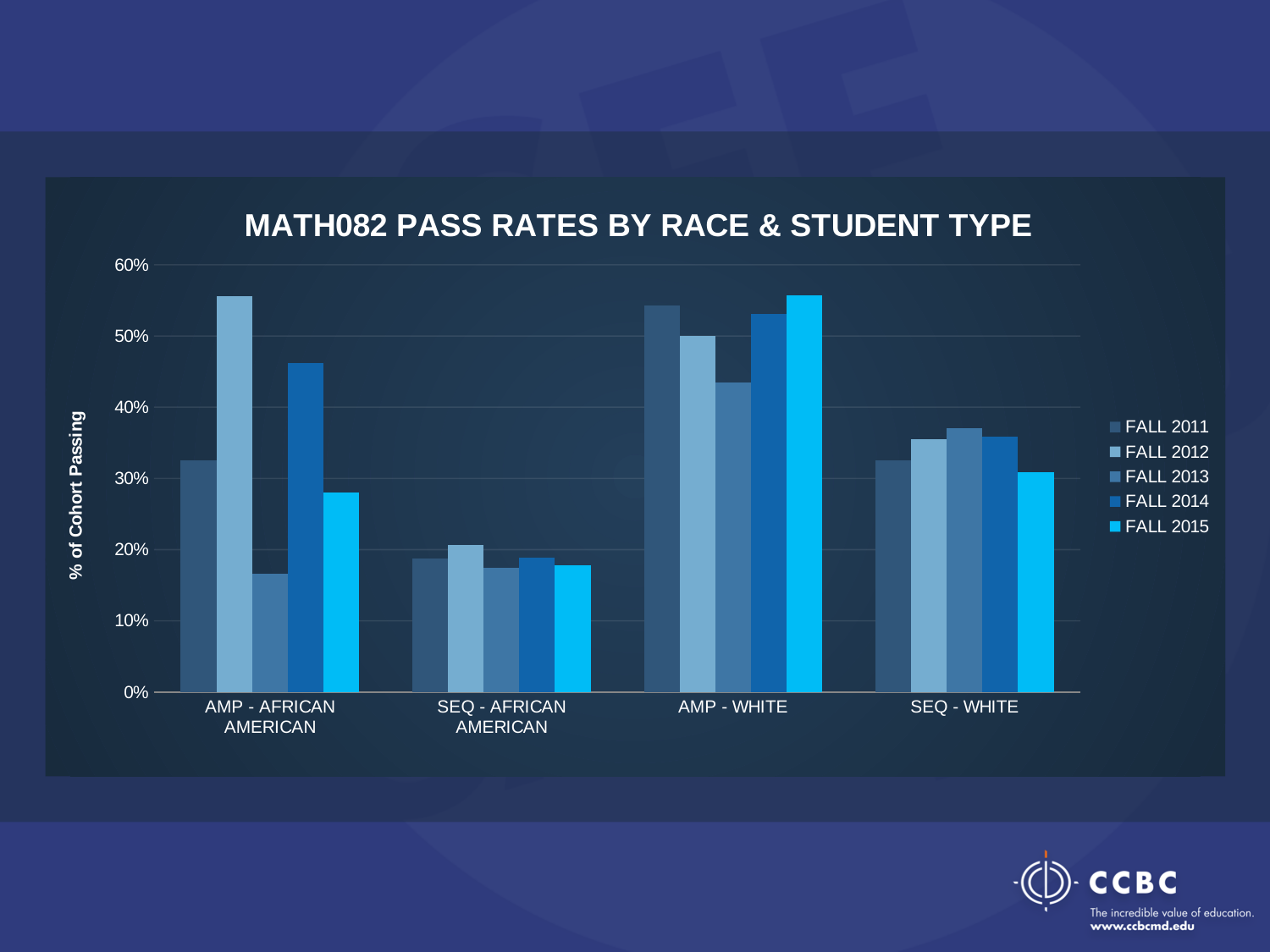
Is the FALL 2012 value for AMP - AFRICAN AMERICAN greater or less than 50%? greater What kind of chart is shown on the slide? bar chart What is the title of the y axis? % of Cohort Passing How many categories are shown on the x axis? 4 Is the FALL 2012 value for SEQ - AFRICAN AMERICAN greater or less than 30%? less For FALL 2011, which category has the larger value: AMP - WHITE or SEQ - WHITE? AMP - WHITE Which series has the lowest value for AMP - WHITE? FALL 2013 Which series has the highest value for AMP - AFRICAN AMERICAN? FALL 2012 How many series does the legend list? 5 Is the FALL 2013 value for AMP - AFRICAN AMERICAN greater or less than 20%? less For AMP - AFRICAN AMERICAN, which is larger: the FALL 2014 value or the FALL 2015 value? FALL 2014 Which series has the lowest value for AMP - AFRICAN AMERICAN? FALL 2013